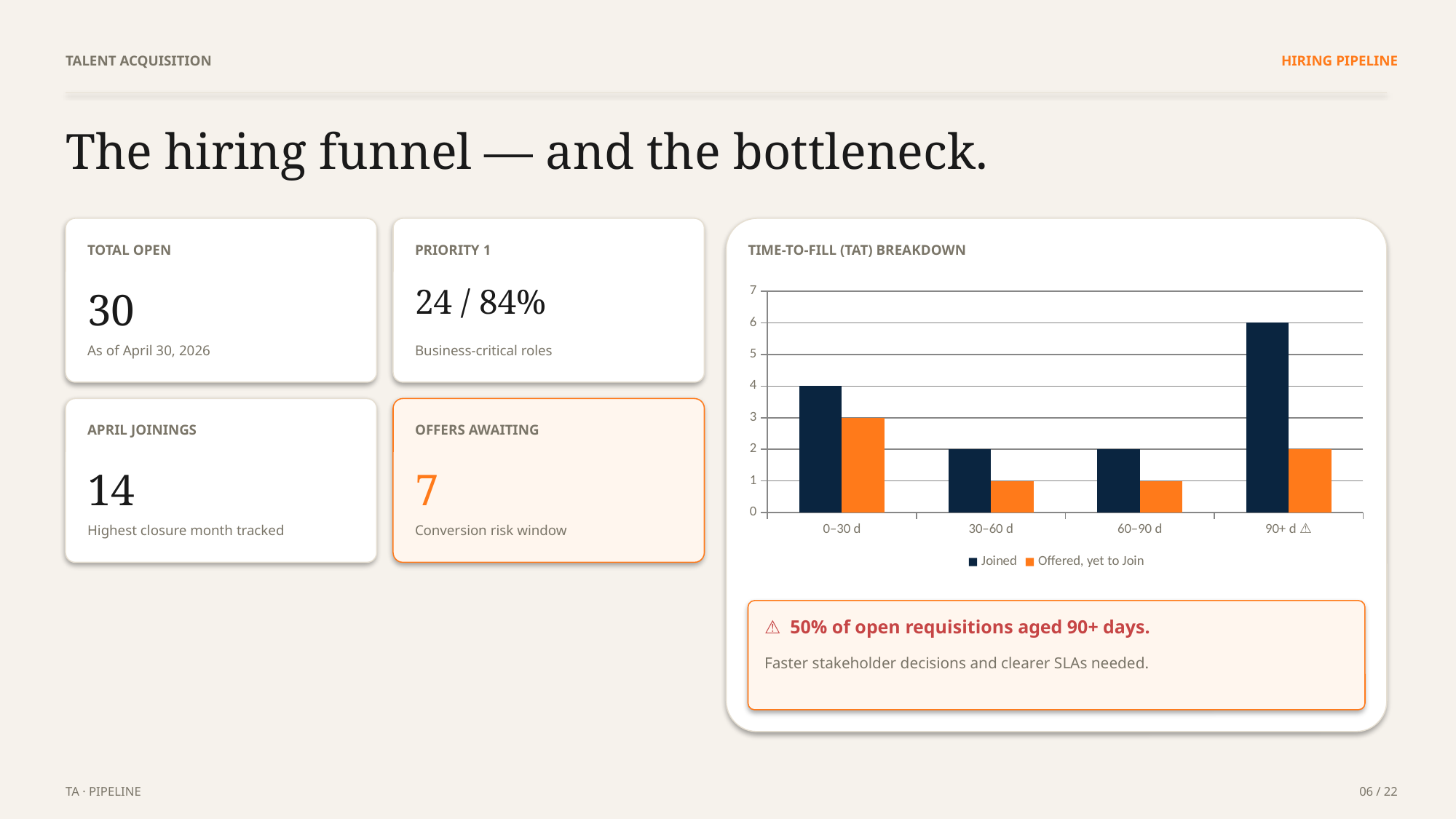
In the Time-to-Fill (TAT) Breakdown chart, is the Joined value for 0–30 d larger or smaller than the Joined value for 30–60 d? larger How many time-bucket categories are shown on the x axis of the Time-to-Fill (TAT) Breakdown chart? 4 In the Time-to-Fill (TAT) Breakdown chart, what is the Offered, yet to Join value for 90+ d? 2 Which category has the highest Joined value in the Time-to-Fill (TAT) Breakdown chart? 90+ d In the Time-to-Fill (TAT) Breakdown chart, is the Joined value for 90+ d greater or less than 5? greater How many series does the legend of the Time-to-Fill (TAT) Breakdown chart list? 2 What colour are the Joined bars in the Time-to-Fill (TAT) Breakdown chart? dark navy Which category has the highest Offered, yet to Join value in the Time-to-Fill (TAT) Breakdown chart? 0–30 d In the Time-to-Fill (TAT) Breakdown chart, what is the Joined value for 0–30 d? 4 In the Time-to-Fill (TAT) Breakdown chart, what is the difference between the Joined and Offered, yet to Join values for 90+ d? 4 In the Time-to-Fill (TAT) Breakdown chart, what is the Joined value for 90+ d? 6 What type of chart is the Time-to-Fill (TAT) Breakdown? bar chart